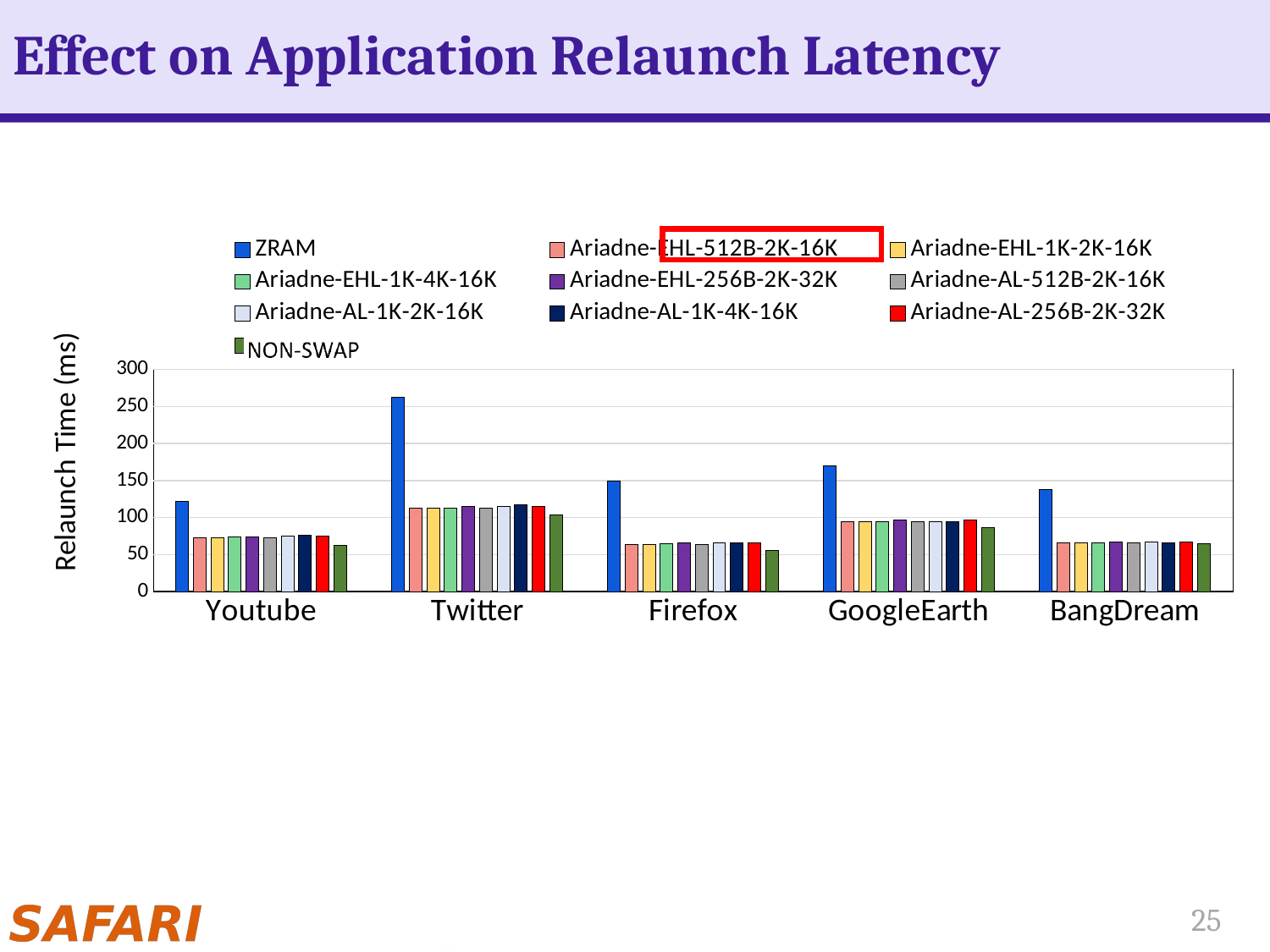
Is the ZRAM value for GoogleEarth greater or less than 150? greater How many series does the legend list? 10 For which application is the ZRAM relaunch time highest? Twitter Which is larger, the ZRAM value for Twitter or the ZRAM value for Firefox? Twitter Is the ZRAM value for Youtube greater or less than 100? greater What is the label of the y axis? Relaunch Time (ms) Which legend entry is outlined with a red box? Ariadne-EHL-512B-2K-16K How many applications (categories) are shown on the x axis? 5 Is the NON-SWAP value for Youtube greater or less than 100? less What kind of chart is shown on the slide? bar chart